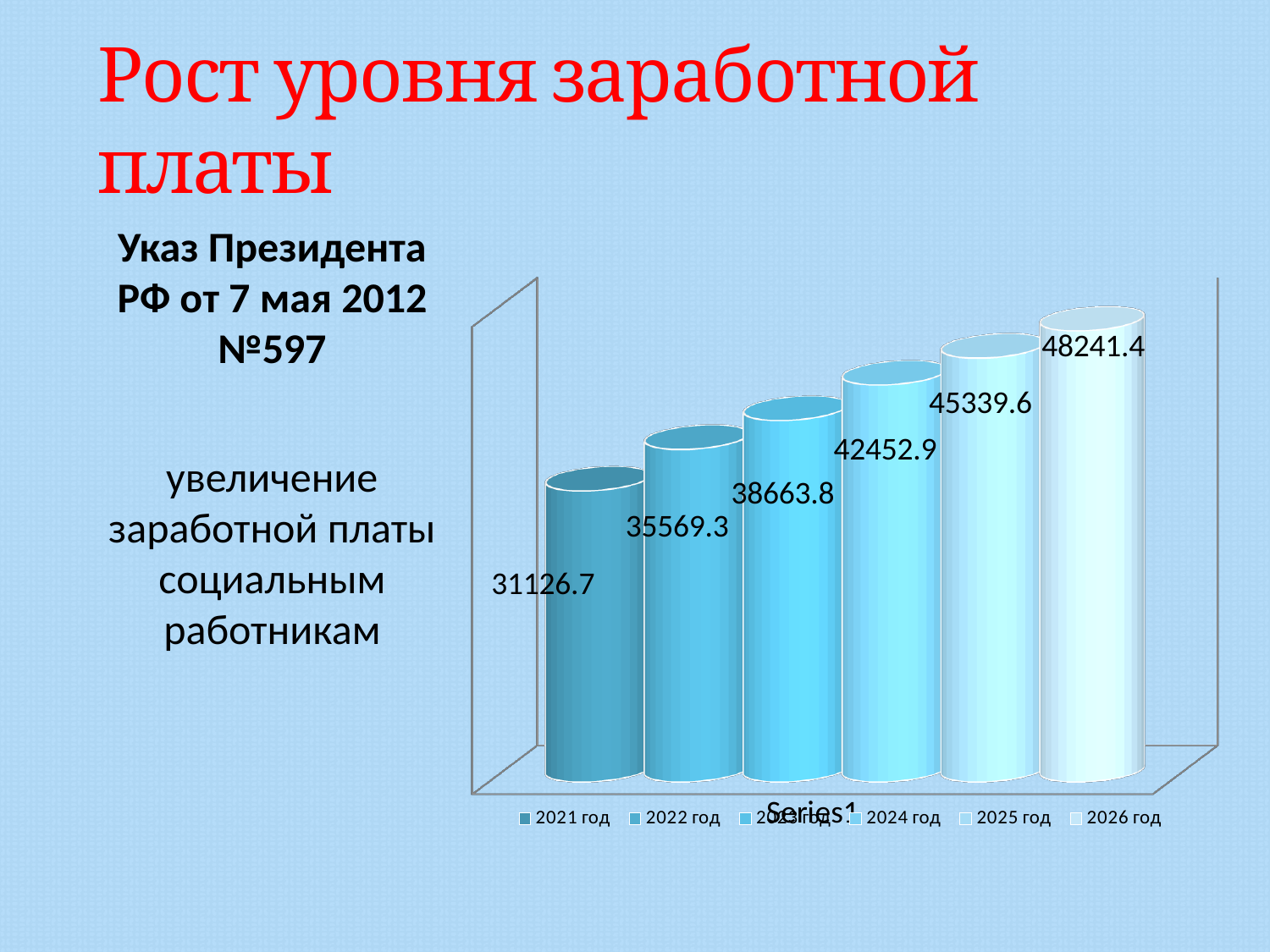
Do the values rise or fall from 2021 год to 2026 год? Rise What is the value for 2024 год? 42452.9 How many entries does the chart legend list? 6 Which year has the lowest value? 2021 год What is the difference between the values for 2022 год and 2021 год? 4442.6 What is the value for 2021 год? 31126.7 What is the value for 2026 год? 48241.4 What kind of chart is shown on the slide? Bar chart What is the difference between the values for 2026 год and 2021 год? 17114.7 Which year has the highest value? 2026 год Which is larger, the value for 2023 год or the value for 2025 год? 2025 год How many bars are plotted in the chart? 6